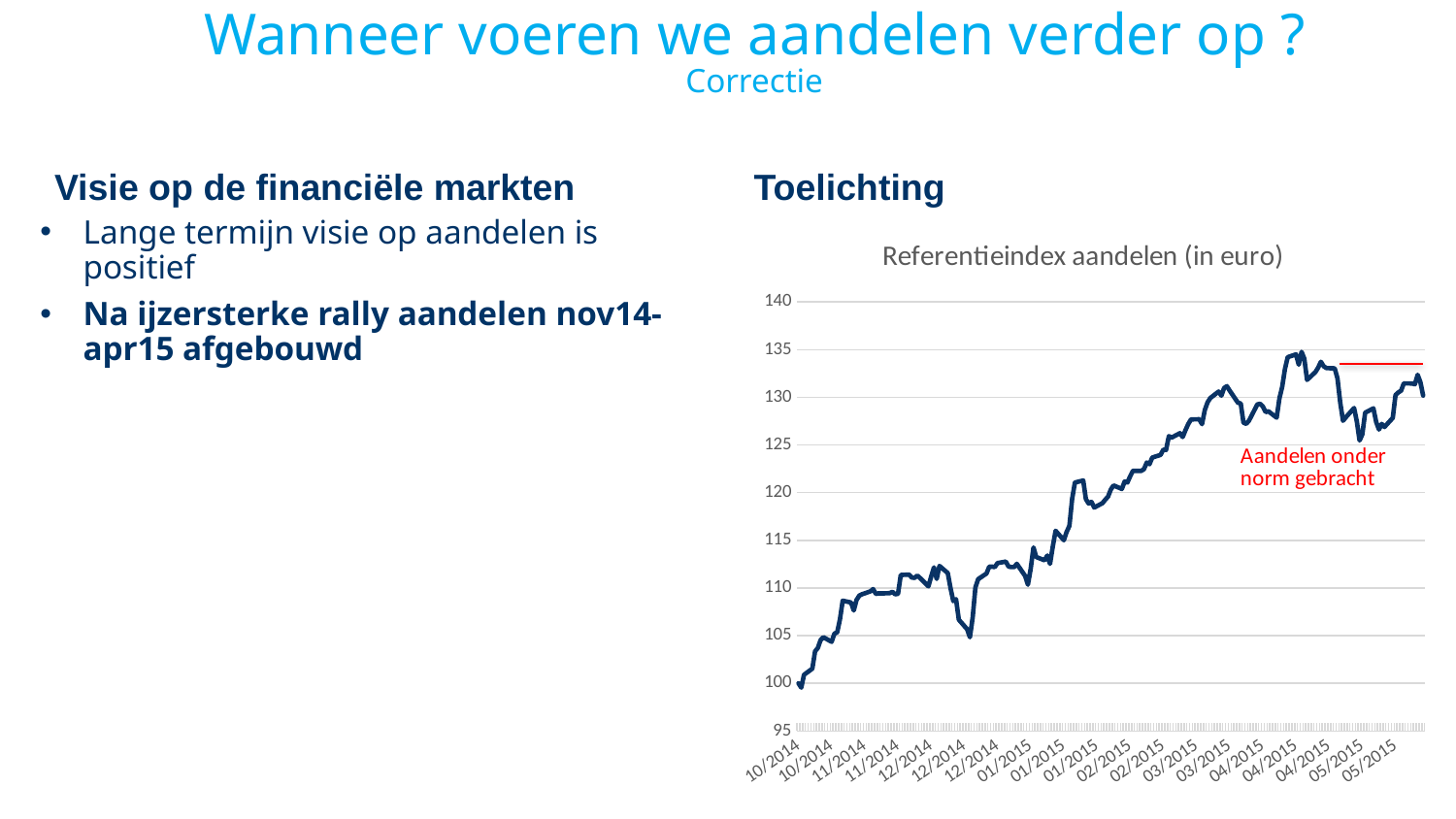
Does the index generally rise or fall from 10/2014 to 04/2015? rise Is the lowest point of the dip around 12/2014 greater or less than 110? less Is the value of the index at the end of the series in 05/2015 greater or less than 125? greater Is the value of the index at the start of the series in 10/2014 greater or less than 105? less What is the title of the chart? Referentieindex aandelen (in euro) Is the index higher in 03/2015 or in 11/2014? 03/2015 What kind of chart is shown on the slide? line chart In which month is the index at its lowest level? 10/2014 In which month does the index reach its highest level? 04/2015 What does the red annotation on the chart say? Aandelen onder norm gebracht